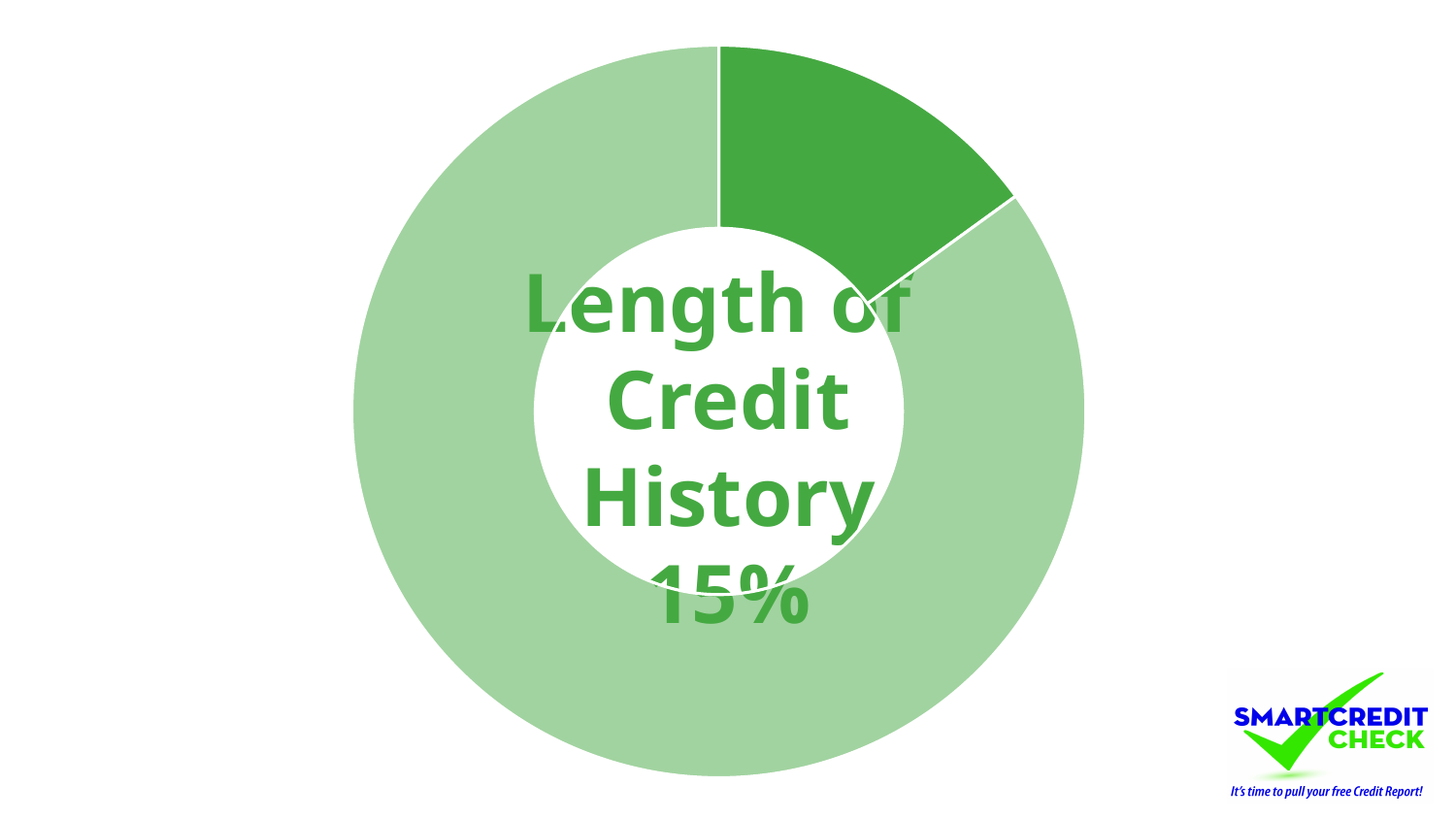
Is the dark green slice's share greater or less than 50%? less Which slice is larger, the dark green slice or the light green slice? The light green slice What text is displayed in the centre of the doughnut chart? Length of Credit History 15% How many slices does the doughnut chart have? 2 What share of the doughnut does the dark green slice represent? 15% What percentage is shown for Length of Credit History? 15% What kind of chart is shown on the slide? Doughnut (pie) chart What colour is the slice representing Length of Credit History? Dark green